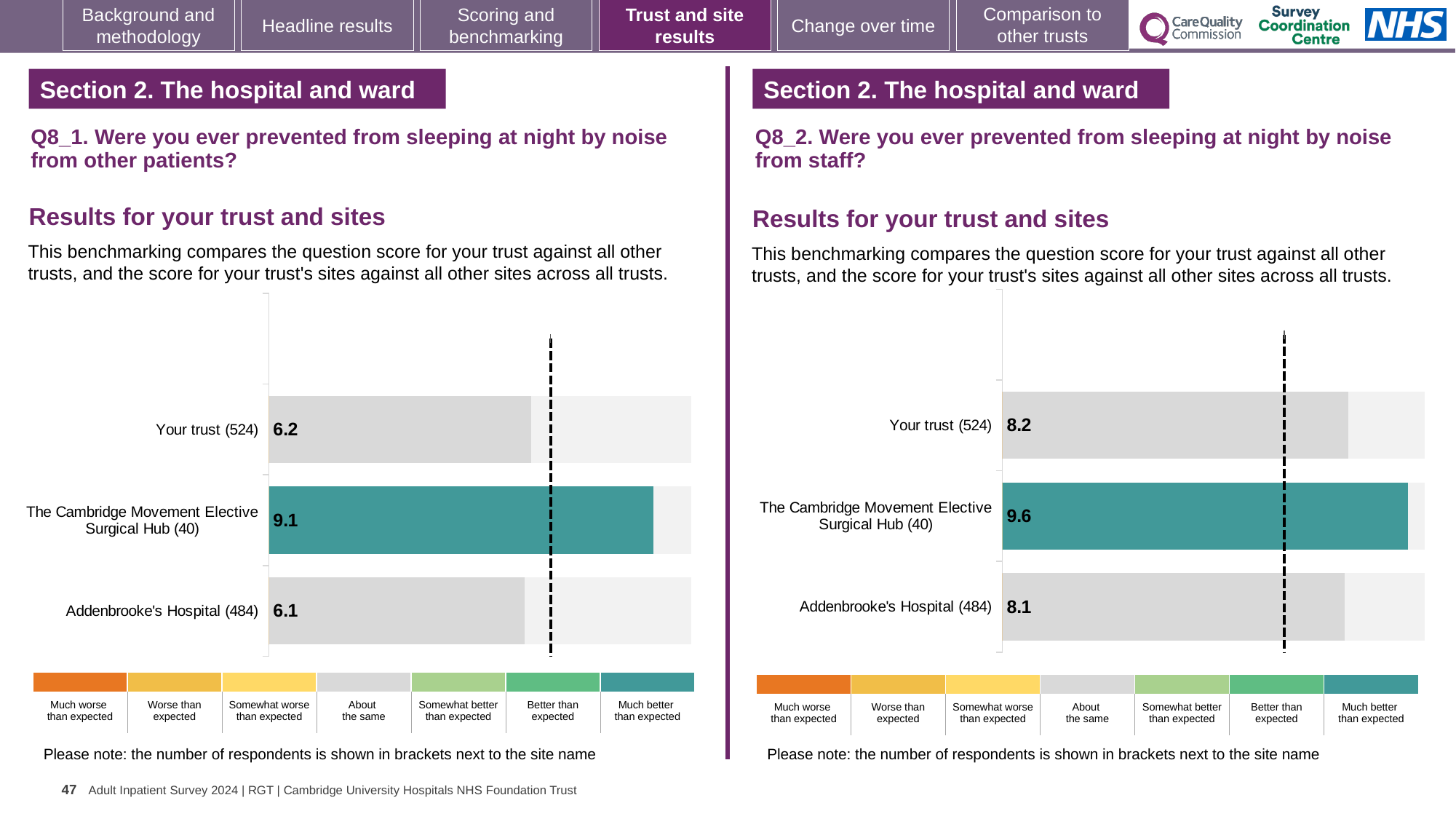
In the Q8_2 chart (noise from staff), what is the score for Addenbrooke's Hospital (484)? 8.1 In the Q8_2 chart (noise from staff), what is the score for Your trust (524)? 8.2 In the Q8_2 chart (noise from staff), which site or trust has the highest score? The Cambridge Movement Elective Surgical Hub (40) How many bars are plotted in the Q8_1 chart (noise from other patients)? 3 In the Q8_1 chart (noise from other patients), what is the score for The Cambridge Movement Elective Surgical Hub (40)? 9.1 In the Q8_1 chart (noise from other patients), which site or trust has the lowest score? Addenbrooke's Hospital (484) In the Q8_2 chart (noise from staff), what is the difference between the score for The Cambridge Movement Elective Surgical Hub (40) and the score for Your trust (524)? 1.4 Is the score for Your trust (524) higher in the Q8_1 chart (noise from other patients) or in the Q8_2 chart (noise from staff)? Q8_2 (noise from staff) In the Q8_1 chart (noise from other patients), what is the score for Your trust (524)? 6.2 In the Q8_1 chart (noise from other patients), what is the score for Addenbrooke's Hospital (484)? 6.1 What type of chart is used on the slide to show the results for your trust and sites? Bar chart In the Q8_1 chart (noise from other patients), what is the difference between the score for The Cambridge Movement Elective Surgical Hub (40) and the score for Addenbrooke's Hospital (484)? 3.0